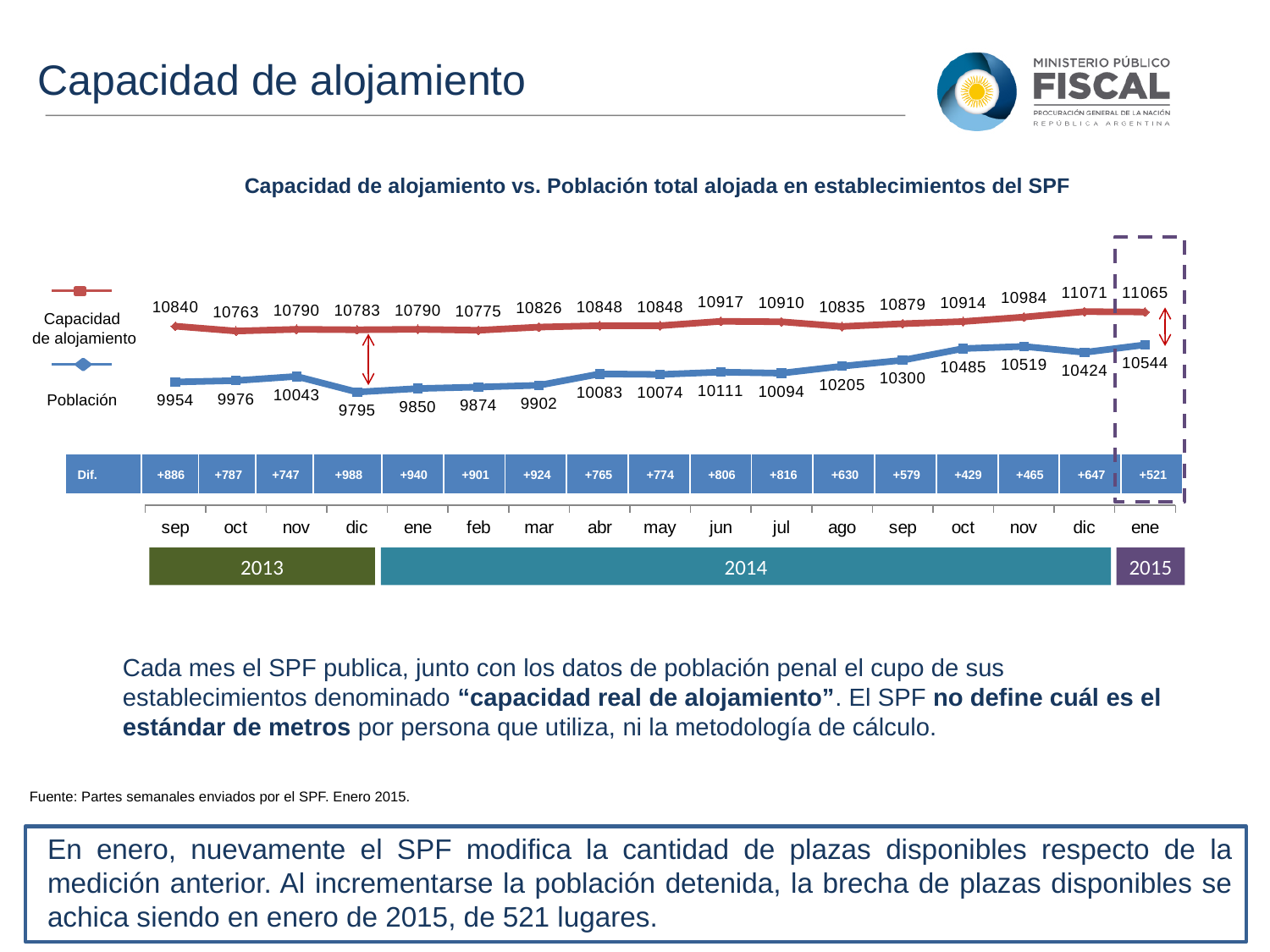
What is the lowest value of Capacidad de alojamiento shown on the chart? 10763 Which is larger in jun 2014: Capacidad de alojamiento or Población? Capacidad de alojamiento What is the value of Población in dic 2013? 9795 By how much did Población increase from sep 2013 to ene 2015? 590 What is the value of Capacidad de alojamiento in sep 2013? 10840 In which month is Población at its lowest value? dic 2013 What is the value of Población in ene 2015? 10544 What is the difference between Capacidad de alojamiento and Población in ene 2015? 521 How many series does the chart show? 2 How many months are plotted on the chart? 17 What type of chart is shown on the slide? Line chart In which month does Capacidad de alojamiento reach its highest value? dic 2014